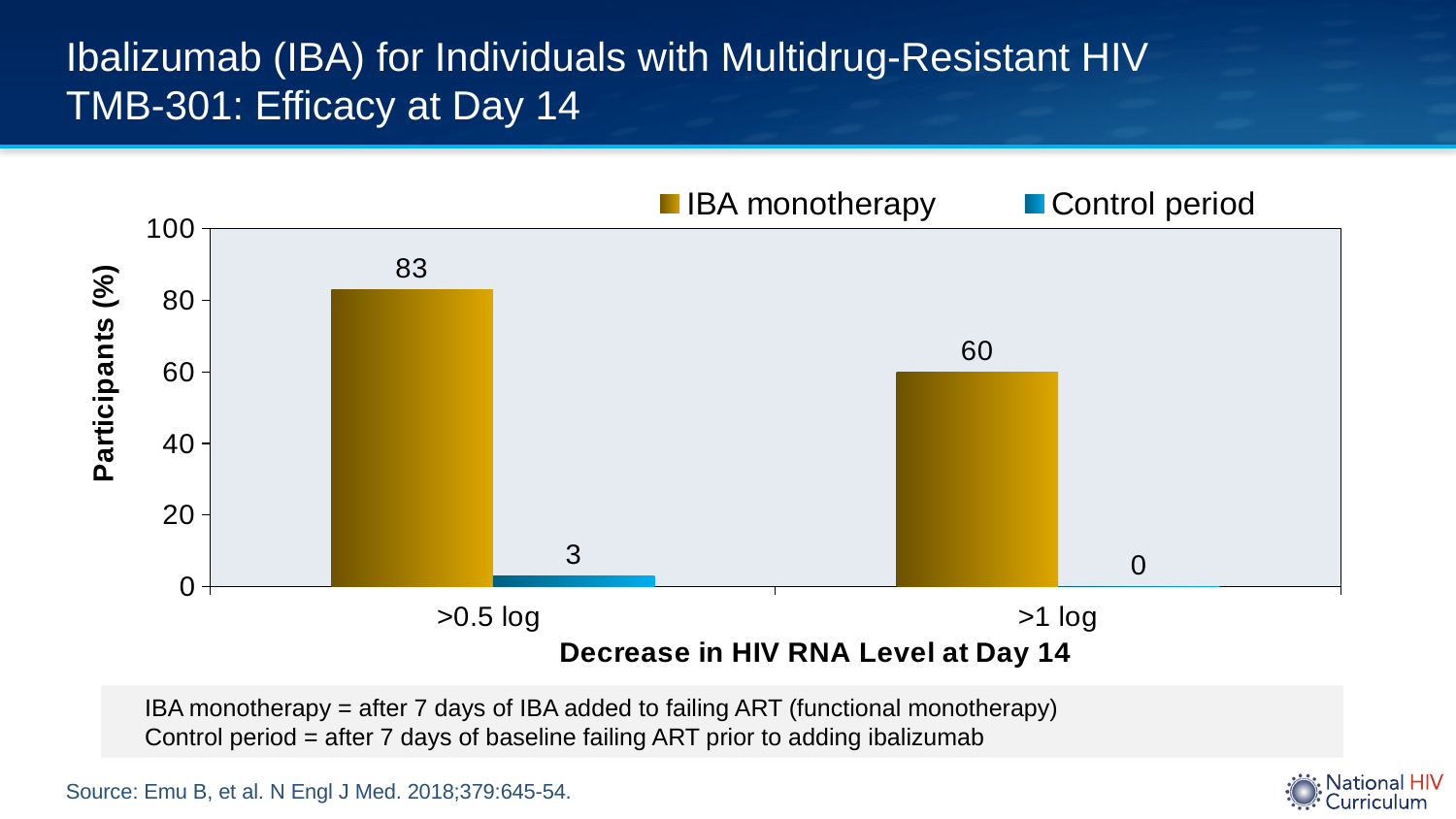
What is the label of the x axis? Decrease in HIV RNA Level at Day 14 What is the value for IBA monotherapy in the >1 log category? 60 Which category has the lowest value for Control period? >1 log Which is larger in the >1 log category: IBA monotherapy or Control period? IBA monotherapy What is the difference between the IBA monotherapy and Control period values in the >0.5 log category? 80 What kind of chart is shown on the slide? Bar chart What percentage of participants had a >1 log decrease in HIV RNA during the control period? 0 What percentage of participants had a >0.5 log decrease in HIV RNA during IBA monotherapy? 83 Which category has the highest value for IBA monotherapy? >0.5 log How many series does the legend list? 2 What is the difference between the IBA monotherapy values for >0.5 log and >1 log? 23 What is the value for Control period in the >0.5 log category? 3